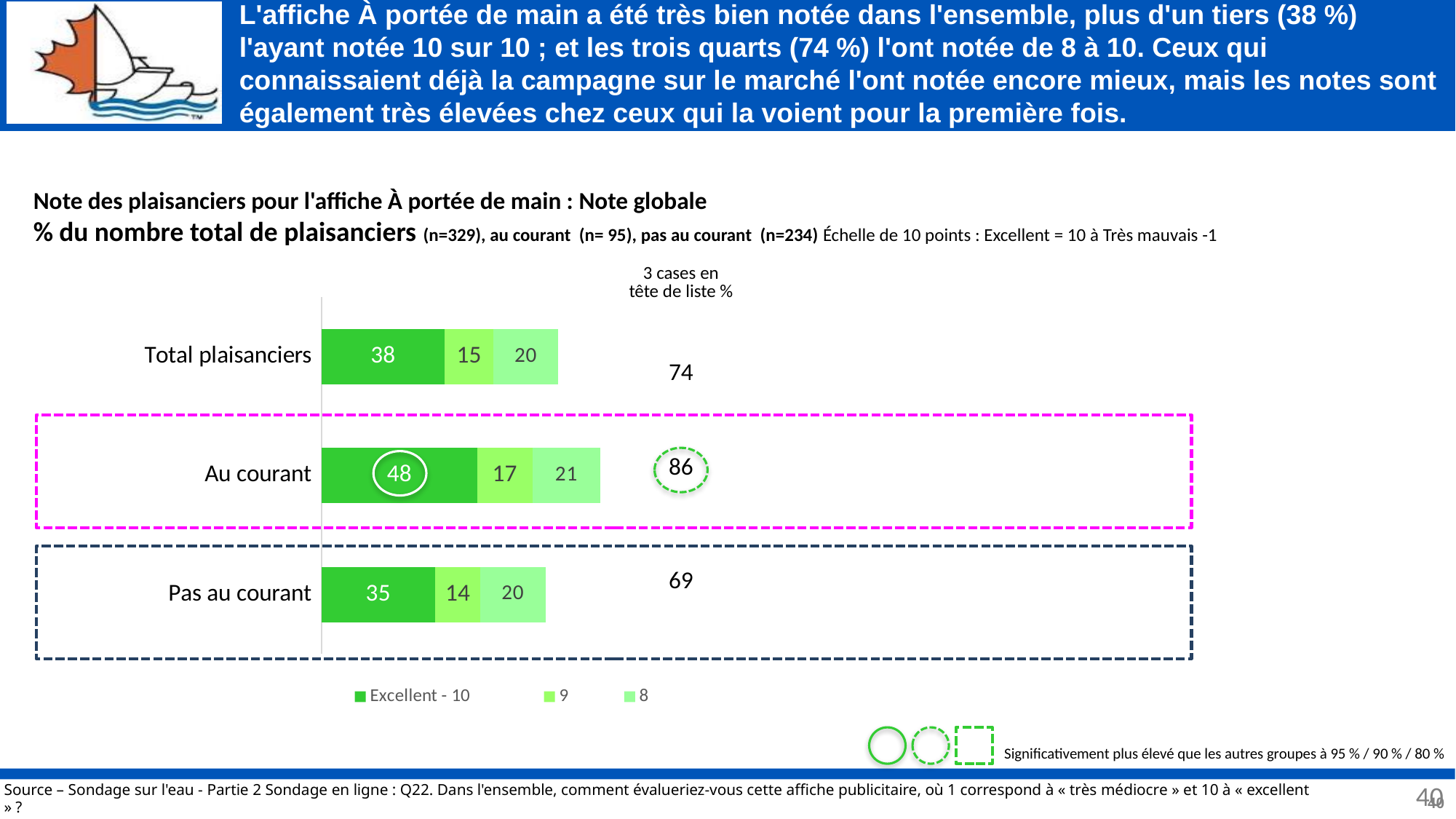
What is the total of the stacked bar for Pas au courant? 69 What is the value for 'Excellent - 10' for Au courant? 48 Which category has the lowest 'Excellent - 10' value? Pas au courant What is the '3 cases en tête de liste %' value for Au courant? 86 What is the difference between the 'Excellent - 10' values for Au courant and Pas au courant? 13 What is the '3 cases en tête de liste %' value for Pas au courant? 69 What is the value for '9' for Pas au courant? 14 What kind of chart is shown on the slide? Stacked bar chart Which is larger, the '9' value for Au courant or for Total plaisanciers? Au courant Which category has the highest 'Excellent - 10' value? Au courant What is the value for '8' for Total plaisanciers? 20 How many series does the legend list? 3